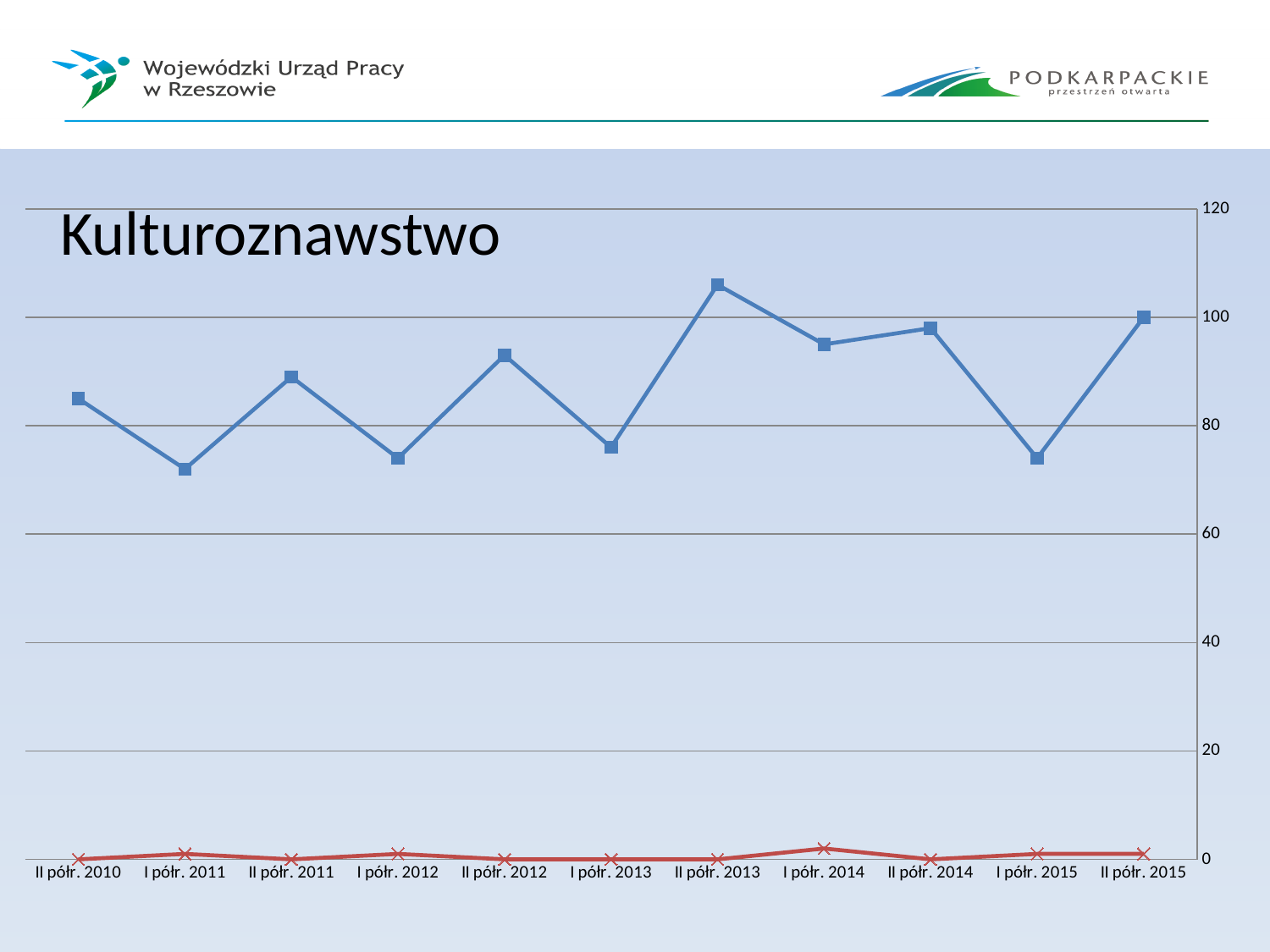
How many lines are plotted on the chart? 2 In which period does the blue line reach its highest value? II półr. 2013 How many periods are shown on the x axis of the chart? 11 Which has the larger value on the blue line: II półr. 2012 or I półr. 2013? II półr. 2012 Is the value of the blue line for I półr. 2013 greater or less than 80? less Does the blue line rise or fall from I półr. 2015 to II półr. 2015? rise What is the title of the chart? Kulturoznawstwo Is the value of the blue line for I półr. 2011 greater or less than 80? less What kind of chart is shown on the slide? line chart Is the value of the red line for I półr. 2014 greater or less than 20? less